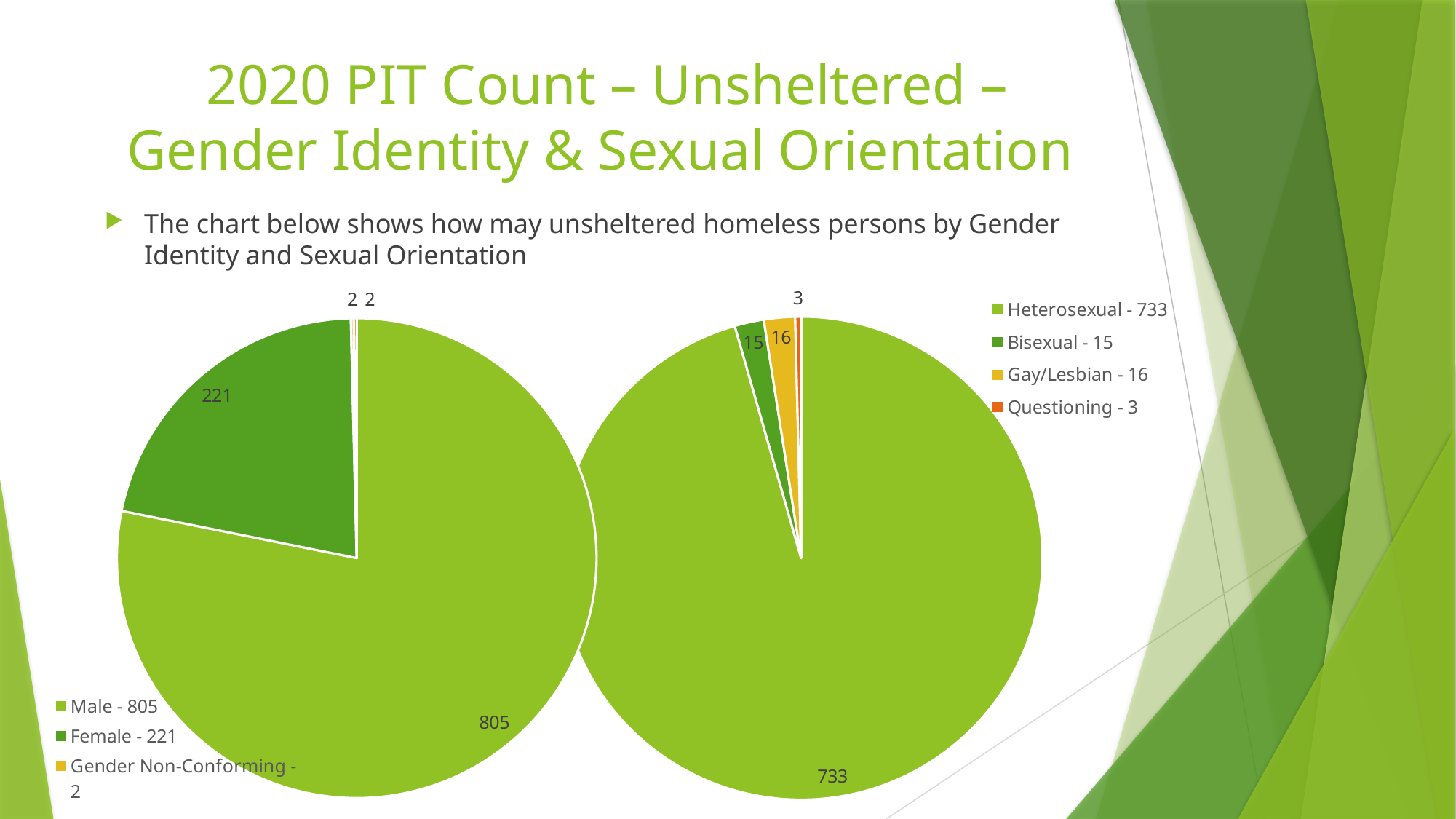
In the right pie chart, what is the value for Gay/Lesbian? 16 In the right pie chart, what is the value for Questioning? 3 In the left pie chart, what is the difference between the Male and Female values? 584 In the right pie chart, which category has the smallest slice? Questioning In the left pie chart, which category has the largest slice? Male In the left pie chart, what is the value for Male? 805 What type of chart is used on this slide? Pie chart In the right pie chart, which is larger, Bisexual or Gay/Lesbian? Gay/Lesbian How many entries does the legend of the right pie chart list? 4 In the right pie chart, what is the difference between the Heterosexual and Bisexual values? 718 In the right pie chart, which category has the largest slice? Heterosexual In the left pie chart, what is the value for Female? 221